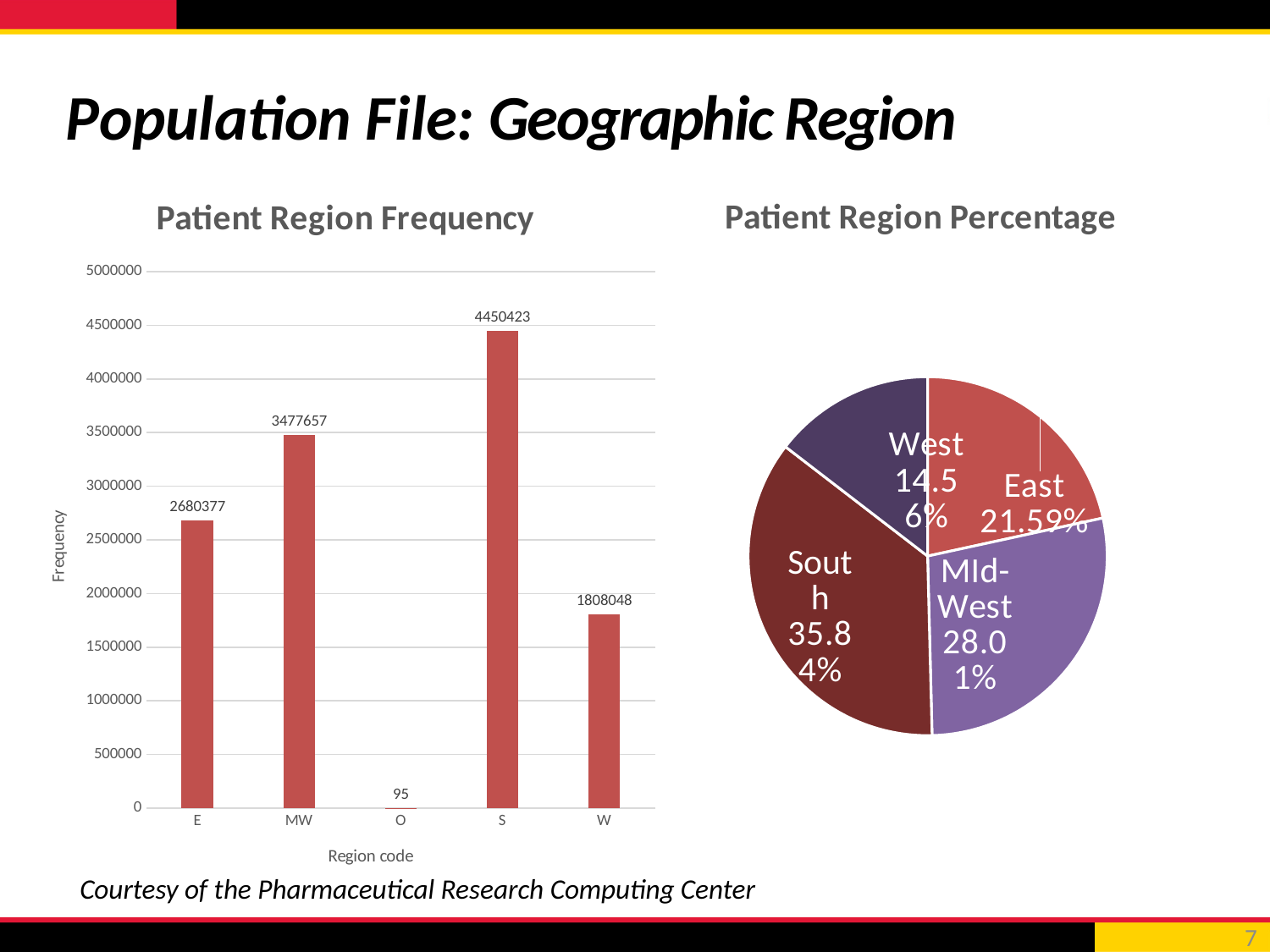
In the Patient Region Percentage chart, what share does the South slice represent? 35.84% What kind of chart is the Patient Region Percentage chart? Pie chart In the Patient Region Frequency chart, what is the frequency for region code O? 95 In the Patient Region Frequency chart, which region code has the lowest frequency? O In the Patient Region Frequency chart, what is the frequency for region code S? 4450423 In the Patient Region Frequency chart, how many region codes are shown on the x axis? 5 What kind of chart is the Patient Region Frequency chart? Bar chart In the Patient Region Frequency chart, which region code has the highest frequency? S In the Patient Region Frequency chart, what is the difference between the frequencies for S and E? 1770046 In the Patient Region Percentage chart, what share does the West slice represent? 14.56% In the Patient Region Frequency chart, what is the frequency for region code MW? 3477657 In the Patient Region Frequency chart, which has a larger frequency, E or W? E